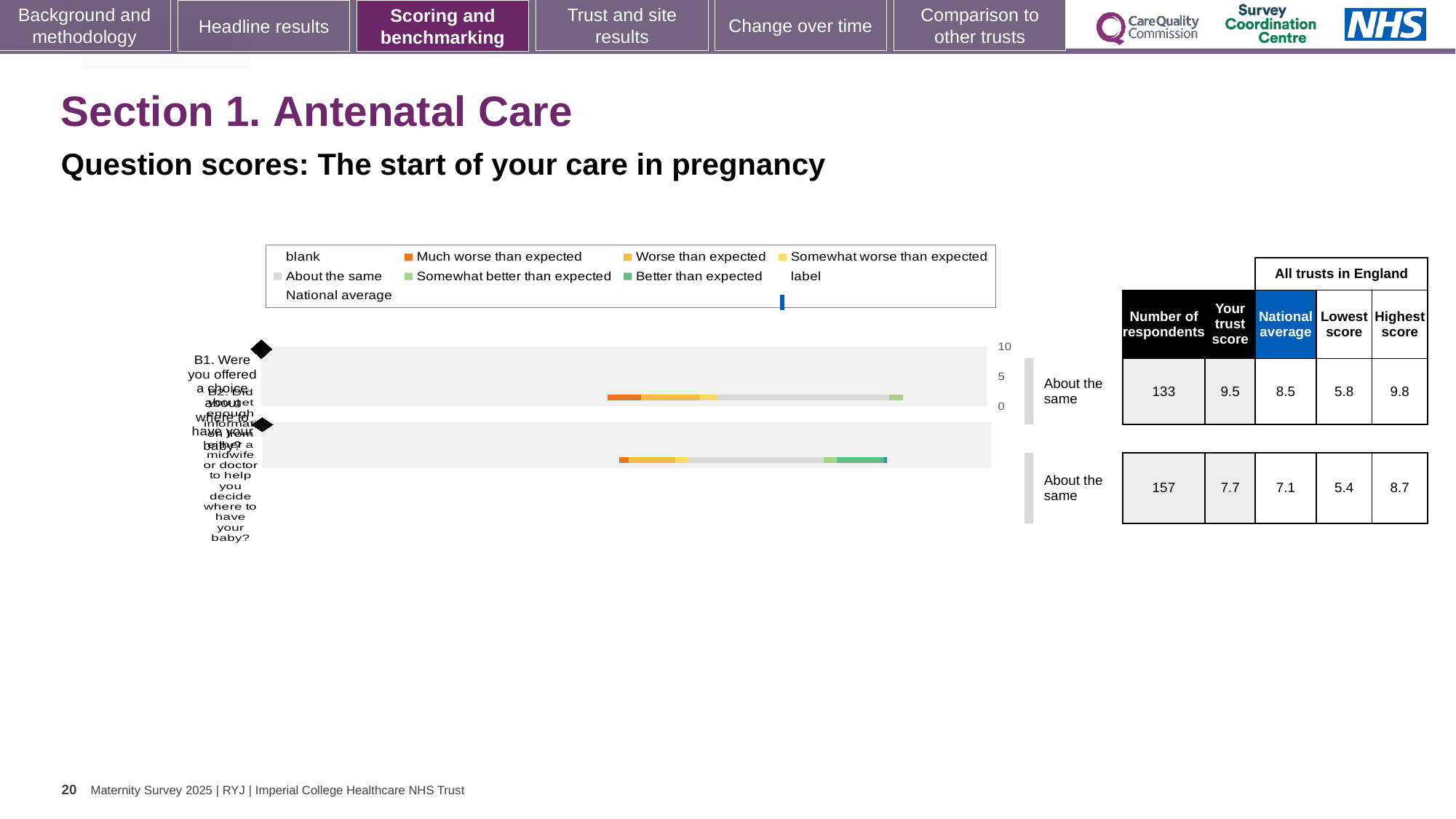
What kind of chart is shown on the slide? bar chart What is the highest score across all trusts in England for B1? 9.8 In the table next to the chart, what is the trust score for B1 (Were you offered a choice about where to have your baby?)? 9.5 Which question has the higher trust score, B1 or B2? B1 In the table next to the chart, what is the national average for B2 (Did you get enough information from either a midwife or doctor to help you decide where to have your baby?)? 7.1 What is the lowest score across all trusts in England for B2? 5.4 What colour does the legend use for 'Much worse than expected'? orange How many respondents answered question B2 according to the table? 157 What is the difference between the trust score and the national average for B1? 1.0 How many questions (categories) are plotted in the chart? 2 How many respondents answered question B1 according to the table? 133 What colour does the legend use for 'National average'? blue